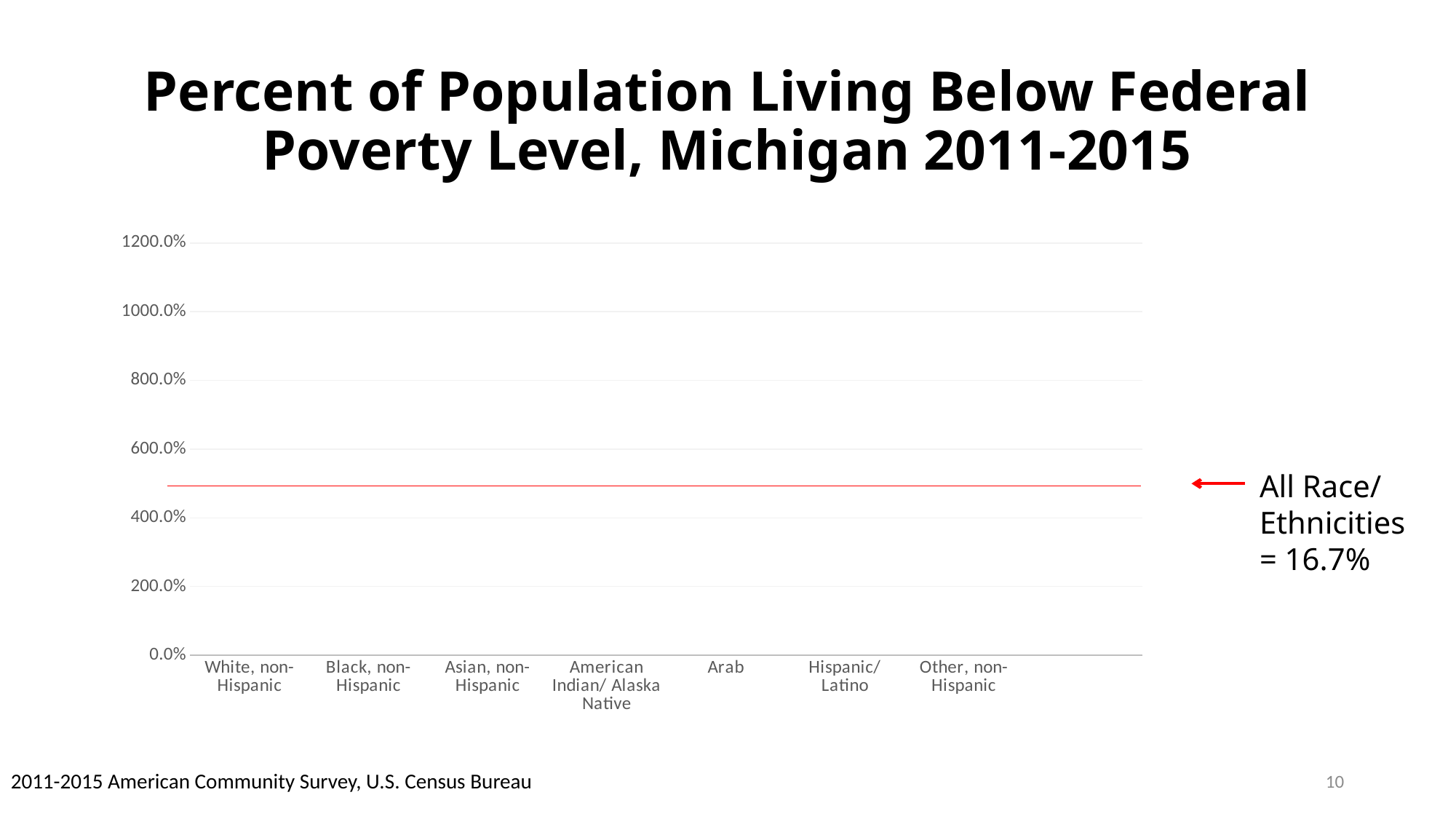
According to the annotation next to the chart, what is the poverty rate for All Race/Ethnicities? 16.7% What is the label of the first category on the x axis of the chart? White, non-Hispanic What is the title of the chart? Percent of Population Living Below Federal Poverty Level, Michigan 2011-2015 How many race/ethnicity categories are listed along the x axis of the chart? 7